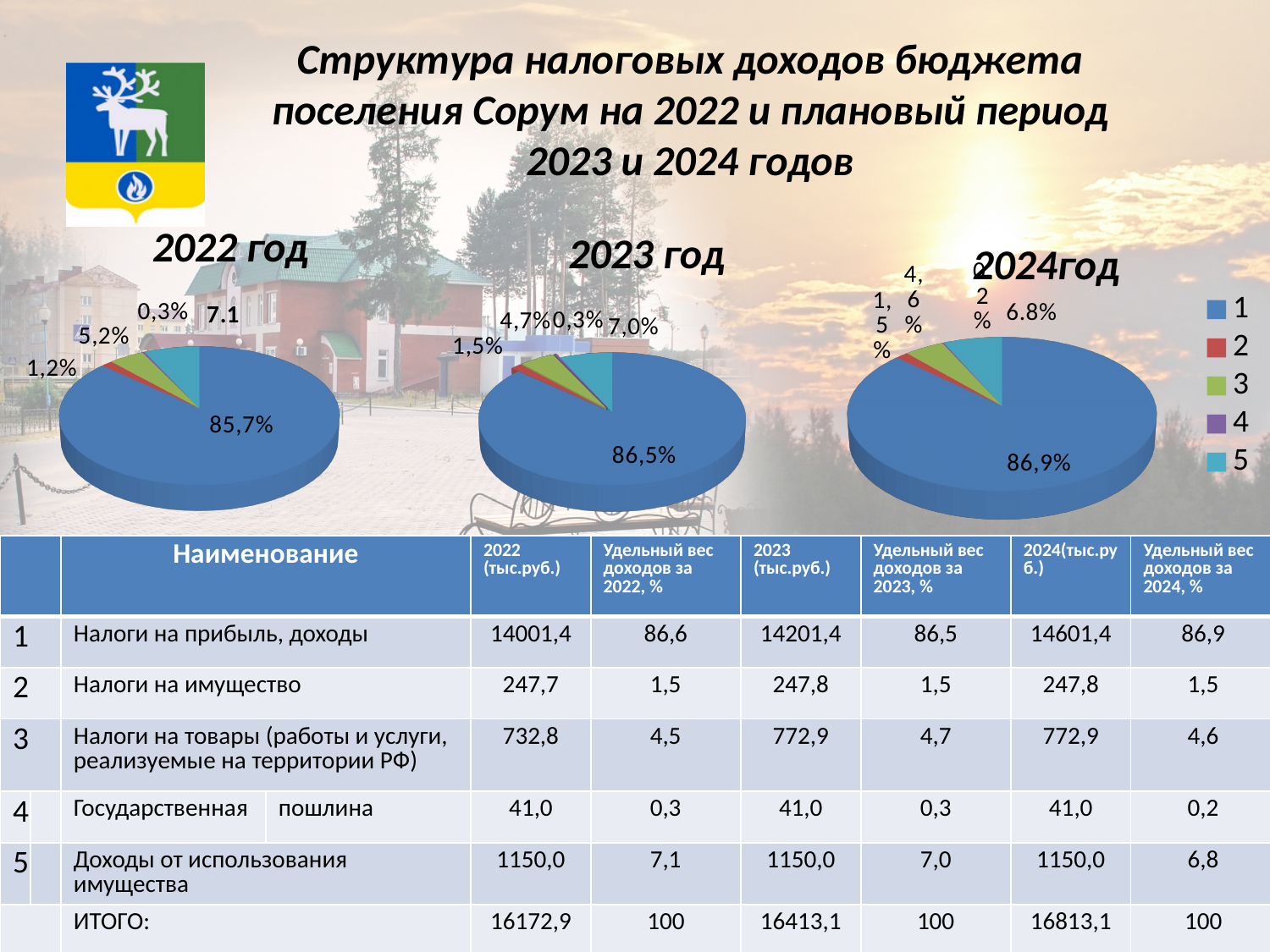
Which of the three pie charts has the largest value for its biggest slice? 2024год In the 2024год pie chart, what is the value of the largest slice? 86,9% How many entries does the legend list for the pie charts? 5 In the 2022 год pie chart, what is the smallest labelled value? 0,3% In the 2022 год pie chart, what is the value of the largest slice? 85,7% In the 2023 год pie chart, which is larger: the slice labelled 4,7% or the slice labelled 7,0%? 7,0% What kind of charts are shown on the slide? Pie charts What colour is the largest slice in each of the pie charts? Blue In the 2022 год pie chart, what is the difference between the slice labelled 5,2% and the slice labelled 1,2%? 4,0% In the 2024год pie chart, what is the smallest labelled value? 0,2% In the 2023 год pie chart, what is the value of the largest slice? 86,5% How many pie charts are on the slide? 3